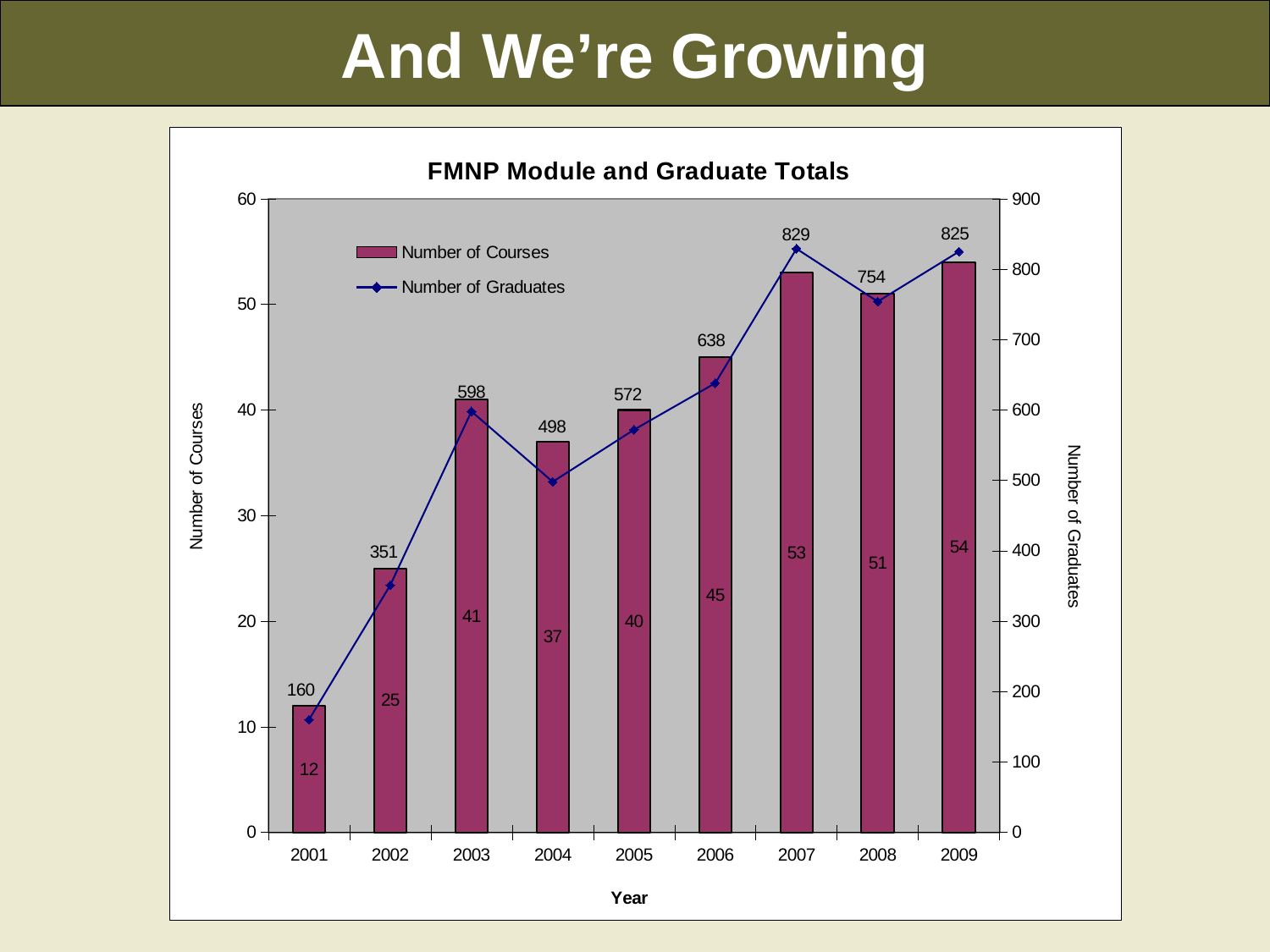
What kind of chart is used for the Number of Courses series? bar chart Which year has more courses, 2003 or 2005? 2003 What is the label of the right-hand vertical axis? Number of Graduates What is the Number of Courses in 2004? 37 What is the difference in Number of Graduates between 2009 and 2008? 71 How many years are shown on the x axis? 9 What is the title of the chart? FMNP Module and Graduate Totals Which year has the lowest Number of Courses? 2001 Which year has the highest Number of Graduates? 2007 Does the Number of Graduates rise or fall from 2003 to 2004? fall How many series does the legend list? 2 What is the Number of Graduates in 2006? 638